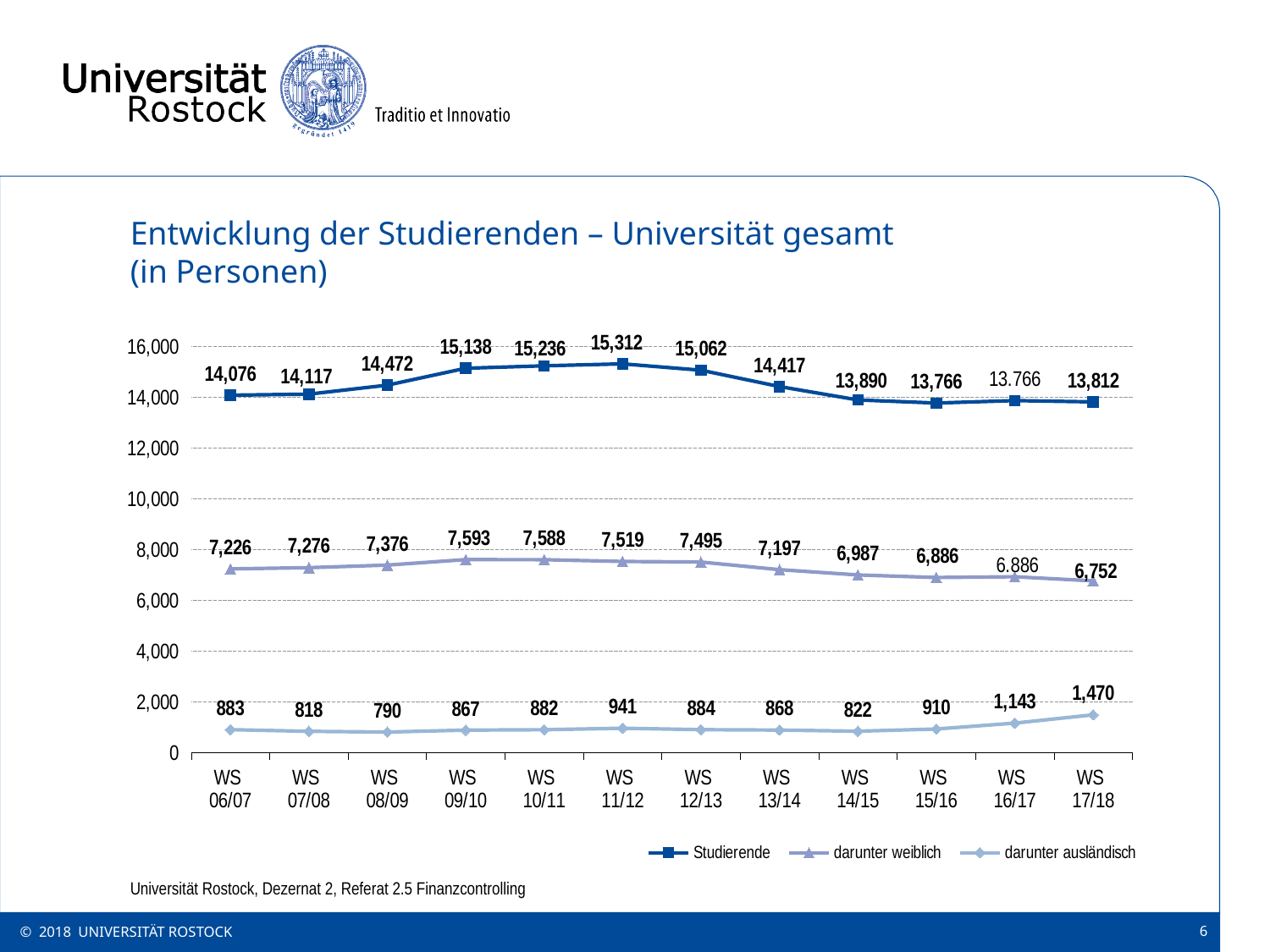
Is the value for darunter weiblich in WS 17/18 greater or less than 8,000? less How many series does the legend list? 3 Which is larger: darunter ausländisch in WS 16/17 or in WS 15/16? WS 16/17 What is the value for darunter ausländisch in WS 17/18? 1,470 What kind of chart is shown on the slide? line chart What is the value for darunter weiblich in WS 09/10? 7,593 What is the difference between the Studierende values in WS 11/12 and WS 06/07? 1,236 What is the value for Studierende in WS 11/12? 15,312 In which winter semester is the darunter ausländisch series at its lowest? WS 08/09 In which winter semester is the Studierende series at its highest? WS 11/12 How many winter semesters (WS) are plotted along the x axis? 12 Does the darunter ausländisch series rise or fall from WS 14/15 to WS 17/18? rise